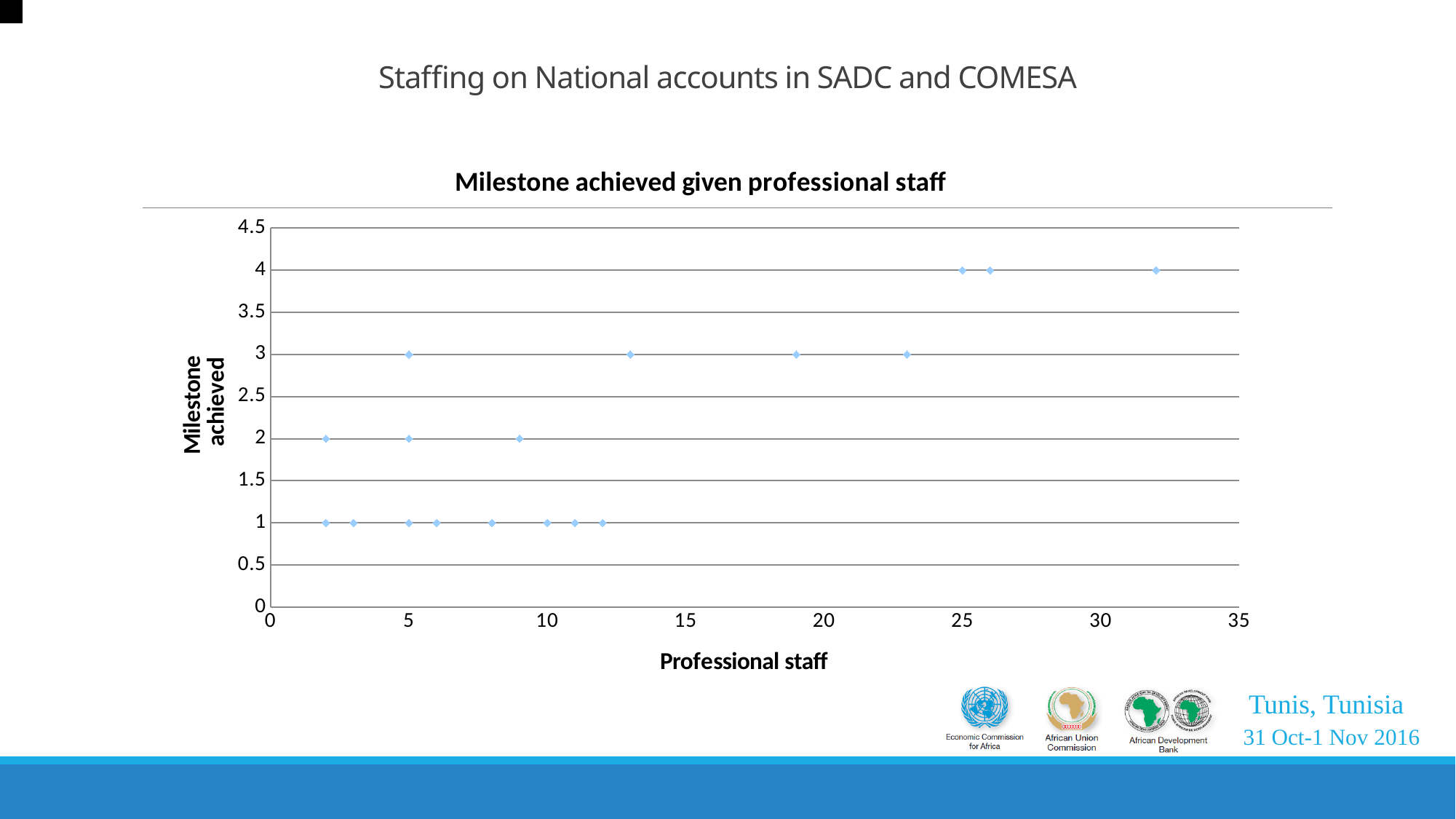
What kind of chart is shown on the slide? Scatter chart What is the label of the x axis? Professional staff How many points are plotted at milestone 4? 3 What is the highest milestone achieved by any point on the chart? 4 Is the professional staff value for the point with the most staff greater or less than 30? greater How many points are plotted at milestone 3? 4 What is the lowest milestone achieved by any point on the chart? 1 How many points are plotted at milestone 1? 8 Are all points at milestone 4 at professional staff greater or less than 20? greater What is the title of the chart? Milestone achieved given professional staff Does the milestone achieved generally rise or fall as professional staff increases? rise